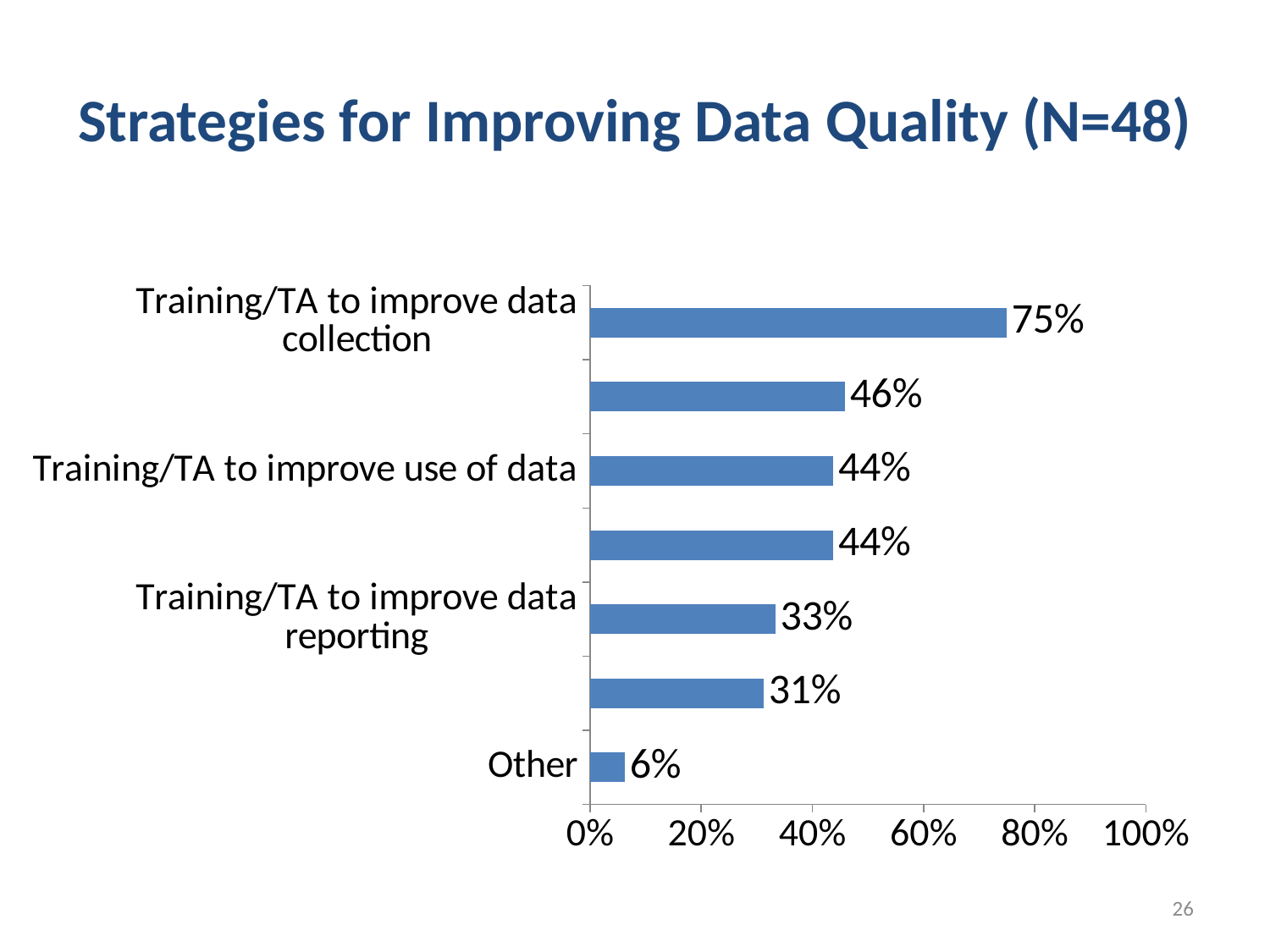
Which category has the lowest percentage? Other What percentage is shown for Training/TA to improve data collection? 75% What percentage is shown for Training/TA to improve use of data? 44% Which strategy has the highest percentage? Training/TA to improve data collection What is the difference between the percentage for Training/TA to improve data collection and the percentage for Other? 69 percentage points Is the value for Training/TA to improve data collection greater or less than 60%? greater Which is larger: the percentage for Training/TA to improve use of data or for Training/TA to improve data reporting? Training/TA to improve use of data What kind of chart is shown on the slide? Bar chart How many bars are plotted in the chart? 7 What is the difference between the percentage for Training/TA to improve data collection and the percentage for Training/TA to improve data reporting? 42 percentage points What percentage is shown for Training/TA to improve data reporting? 33% What percentage is shown for Other? 6%